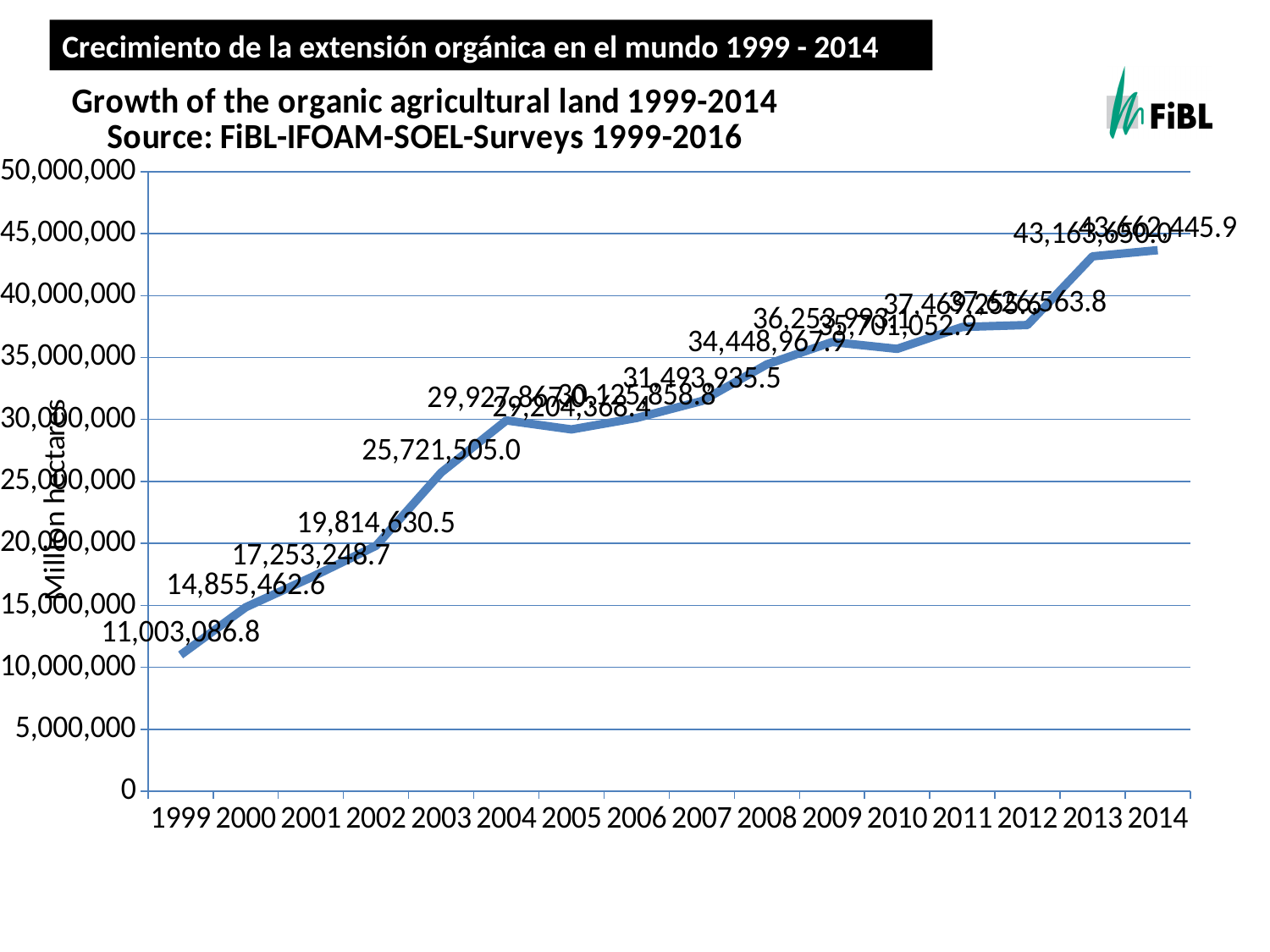
How many years are plotted on the x axis of the chart? 16 What type of chart is shown on the slide? line chart Is the value for 2013 greater or less than 45,000,000? less Which year has a larger value, 2005 or 2007? 2007 What is the difference between the values for 2003 and 2002? 5,906,874.5 What is the value of organic agricultural land for 2010? 35,701,052.9 What is the value of organic agricultural land for 1999? 11,003,086.8 Which year has the highest value of organic agricultural land? 2014 What is the value of organic agricultural land for 2008? 34,448,967.9 What is the value of organic agricultural land for 2003? 25,721,505.0 Which year has the lowest value of organic agricultural land? 1999 What is the label on the y axis of the chart? Million hectares